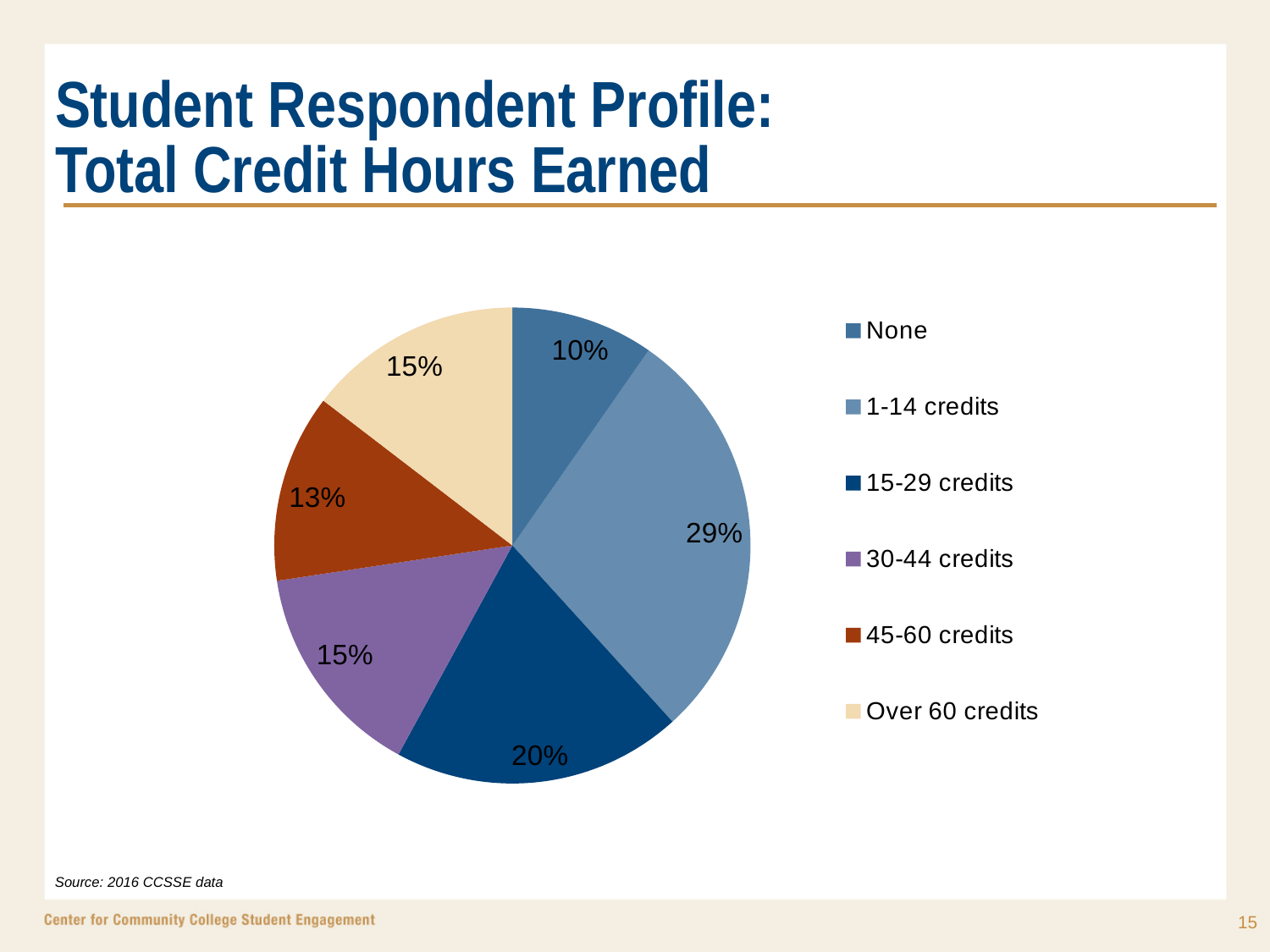
What share of respondents have earned 1-14 credits? 29% What share of respondents have earned 15-29 credits? 20% What share of respondents have earned 45-60 credits? 13% What is the source of the data shown on the slide? 2016 CCSSE data How many categories does the pie chart show? 6 What is the difference in percentage points between the 1-14 credits slice and the 15-29 credits slice? 9 percentage points Which credit-hour category has the largest share of respondents? 1-14 credits Which is larger: the share for 30-44 credits or the share for 45-60 credits? 30-44 credits What kind of chart is shown on the slide? pie chart Which credit-hour category has the smallest share of respondents? None